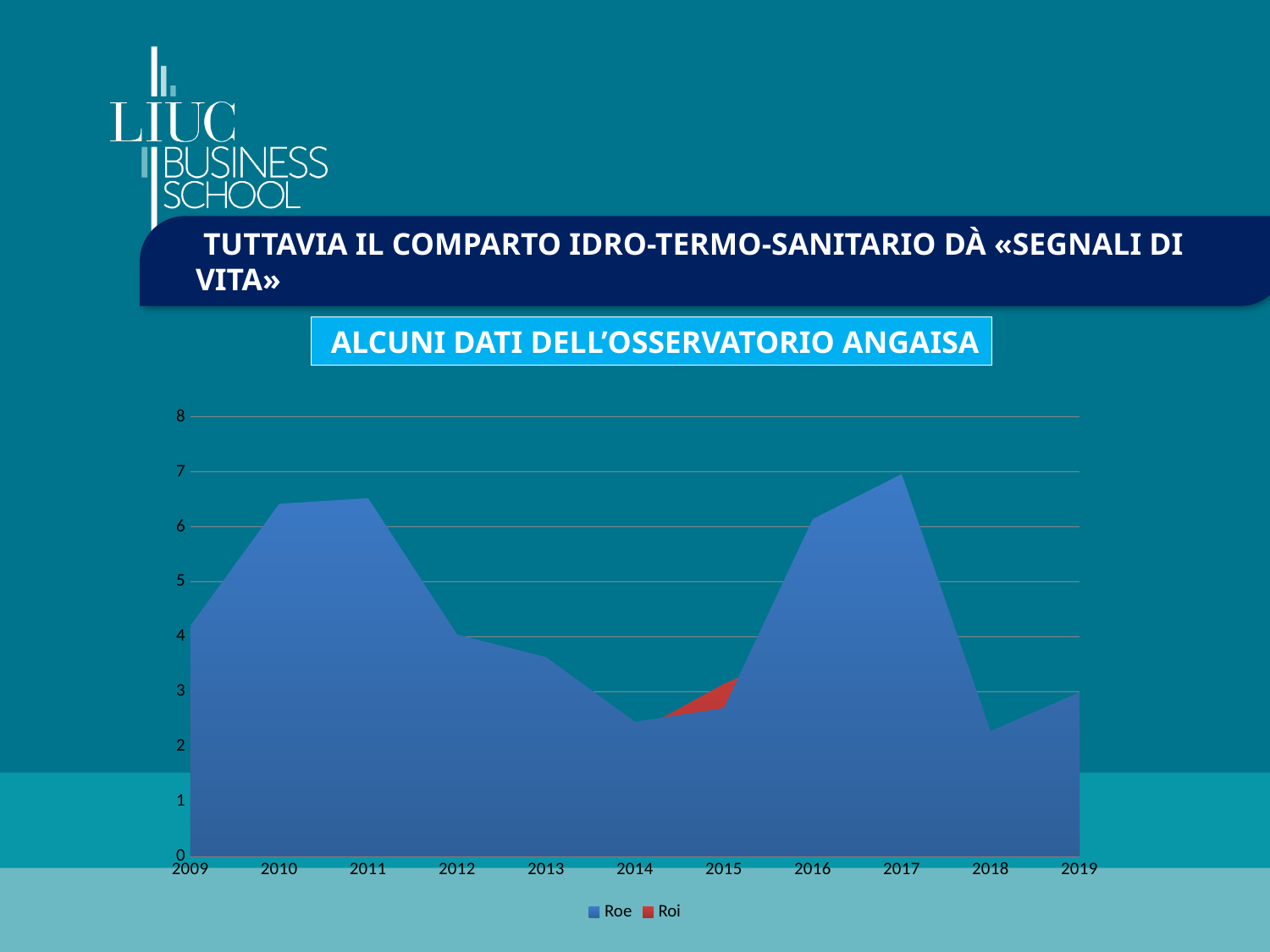
How many years are shown on the x axis? 11 Is the Roe value for 2018 greater or less than 3? less Is the Roe value for 2012 greater or less than 5? less Which year has the larger Roe value, 2011 or 2012? 2011 In which year does the Roe series reach its highest value? 2017 What kind of chart is shown on the slide? area chart Is the Roe value for 2017 greater or less than 6? greater How many series does the legend list? 2 What is the title shown in the box above the chart? ALCUNI DATI DELL'OSSERVATORIO ANGAISA Does the Roe series rise or fall from 2011 to 2014? fall What are the two series named in the legend? Roe and Roi